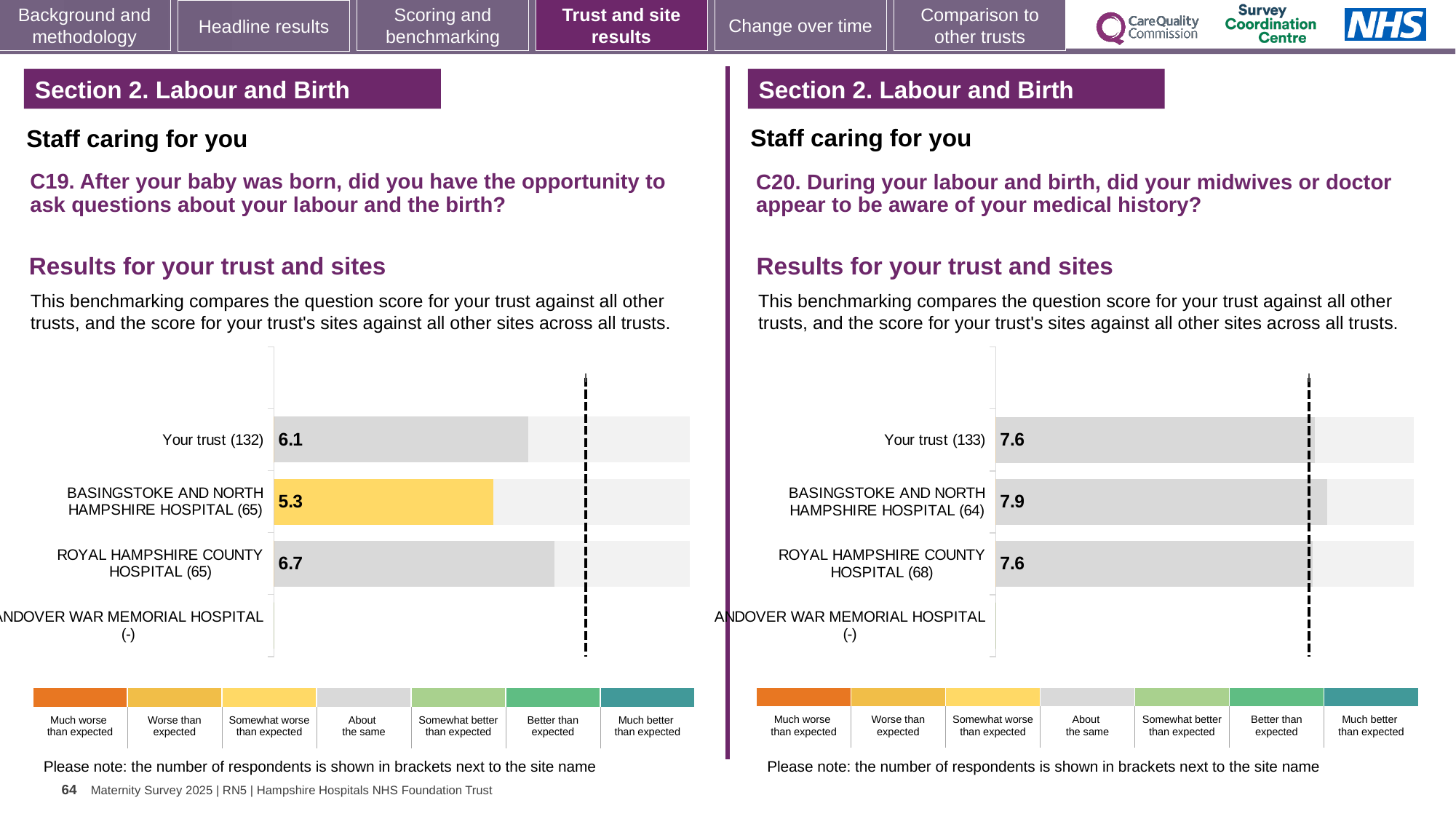
In the C20 chart, what is the score for ROYAL HAMPSHIRE COUNTY HOSPITAL (68)? 7.6 In the C19 chart, which bar is coloured yellow rather than grey? BASINGSTOKE AND NORTH HAMPSHIRE HOSPITAL (65) In the C20 chart, what is the score for BASINGSTOKE AND NORTH HAMPSHIRE HOSPITAL (64)? 7.9 In the C20 chart, what is the difference between the scores for BASINGSTOKE AND NORTH HAMPSHIRE HOSPITAL (64) and Your trust (133)? 0.3 In the C19 chart, what is the difference between the scores for ROYAL HAMPSHIRE COUNTY HOSPITAL (65) and BASINGSTOKE AND NORTH HAMPSHIRE HOSPITAL (65)? 1.4 What kind of chart is used in the C19 chart? bar chart In the C19 chart, what is the score for BASINGSTOKE AND NORTH HAMPSHIRE HOSPITAL (65)? 5.3 In the C19 chart, what is the score for Your trust (132)? 6.1 In the C19 chart, which labelled bar has the lowest score? BASINGSTOKE AND NORTH HAMPSHIRE HOSPITAL (65) In the C19 chart, which site has the highest score? ROYAL HAMPSHIRE COUNTY HOSPITAL (65) In the C20 chart, is the score for Your trust (133) larger or smaller than the score for BASINGSTOKE AND NORTH HAMPSHIRE HOSPITAL (64)? smaller In the C20 chart, which site has the highest score? BASINGSTOKE AND NORTH HAMPSHIRE HOSPITAL (64)